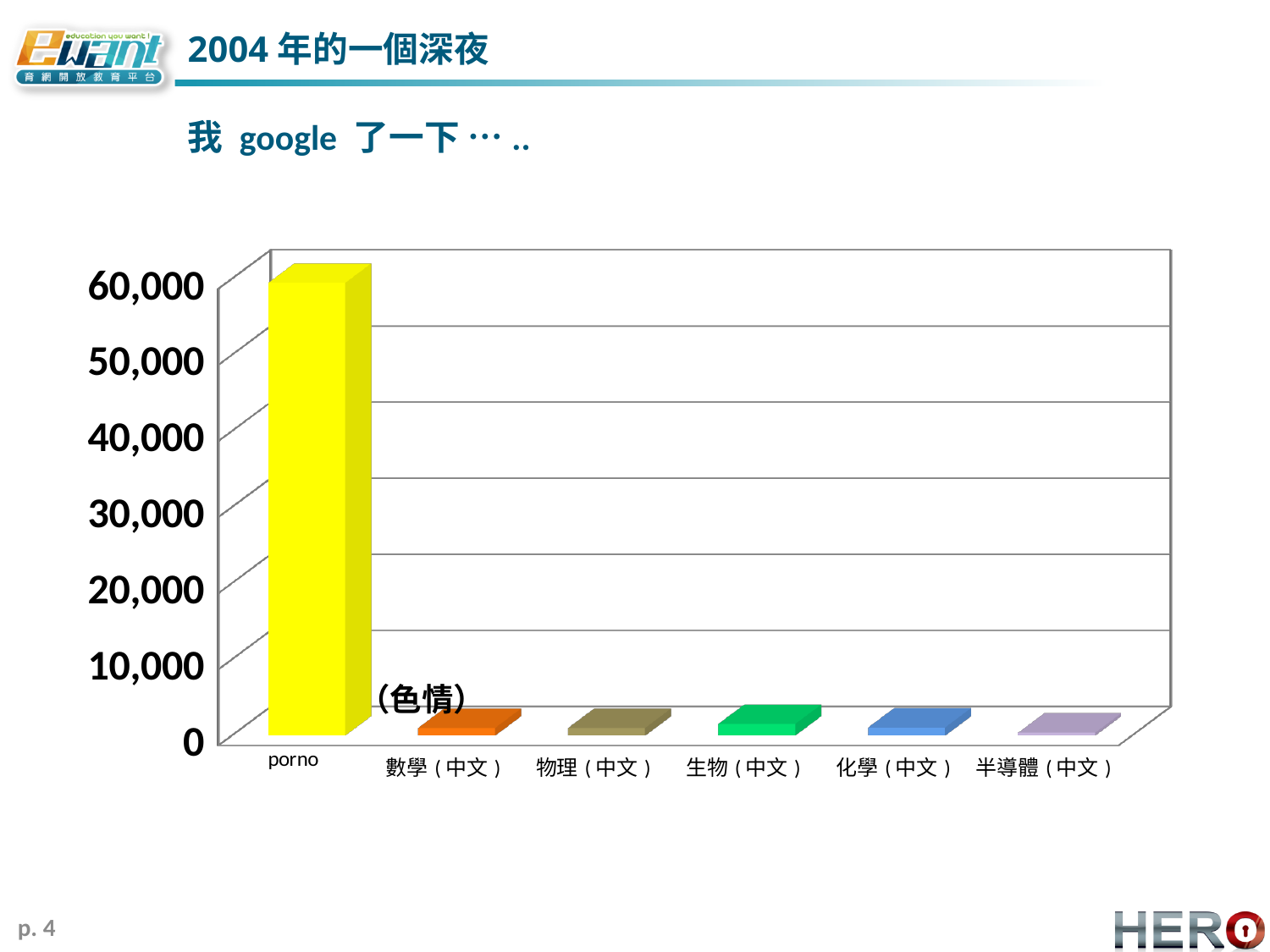
How many categories are shown on the x axis of the chart? 6 Is the value for 半導體 (中文) greater or less than 10,000? less Which is larger, the value for 化學 (中文) or the value for porno? porno What is the highest tick value shown on the y axis of the chart? 60,000 Which is larger, the value for porno or the value for 物理 (中文)? porno What is the label of the last category on the x axis? 半導體 (中文) What colour is the bar for porno? yellow Which category has the highest bar in the chart? porno What kind of chart is shown on the slide? bar chart Is the value for porno greater or less than 50,000? greater What is the label of the first category on the x axis? porno Is the value for 數學 (中文) greater or less than 10,000? less